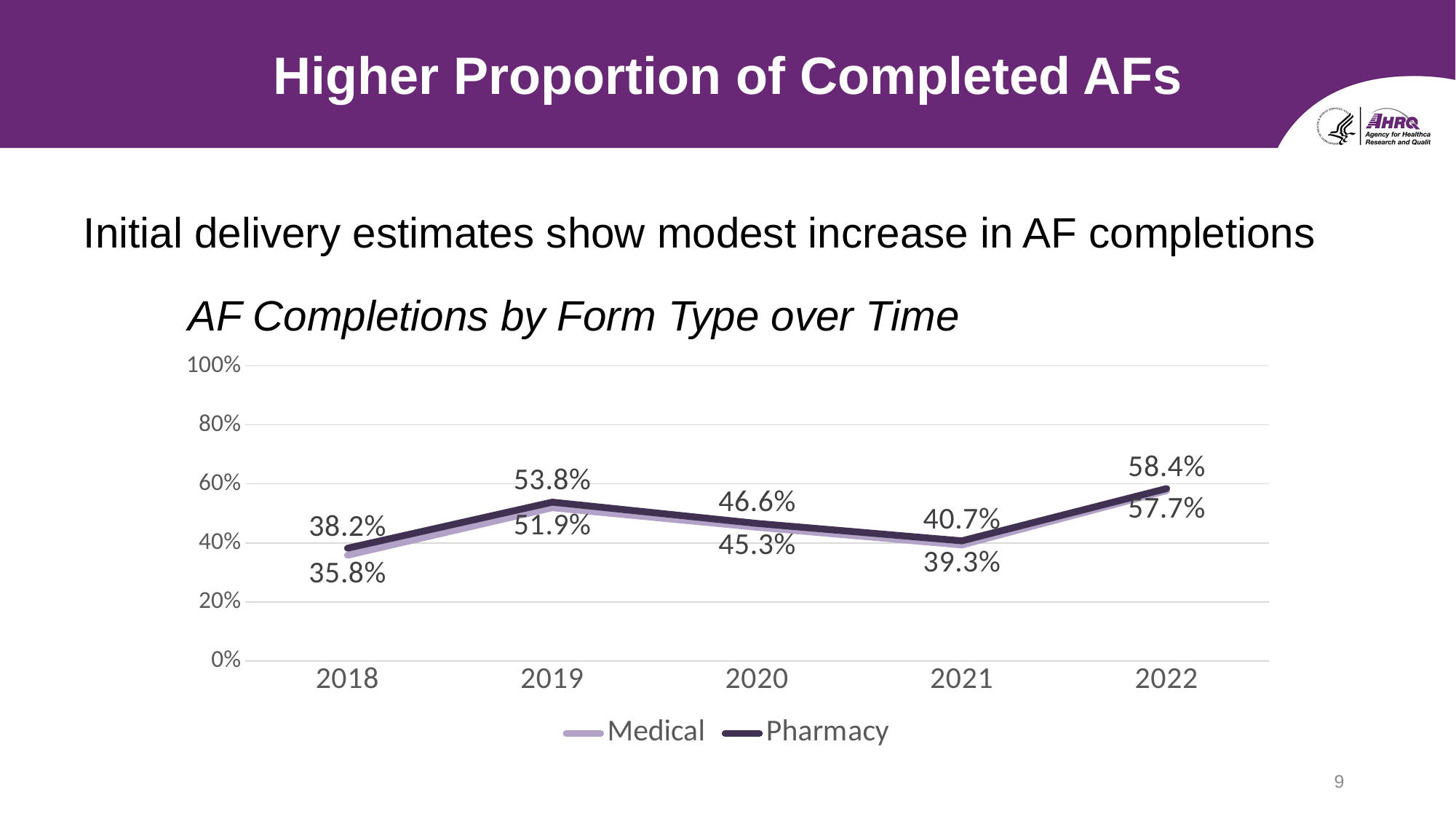
How many series does the legend list? 2 How many years are shown on the x axis? 5 Which is larger in 2020, the Pharmacy value or the Medical value? Pharmacy What kind of chart is shown on the slide? Line chart What is the title of the chart? AF Completions by Form Type over Time What is the difference between the Pharmacy and Medical values in 2019? 1.9% What is the Medical value for 2018? 35.8% What is the Pharmacy value for 2021? 40.7% In which year is the Pharmacy value highest? 2022 What is the Pharmacy value for 2022? 58.4% What is the Medical value for 2020? 45.3% In which year is the Medical value lowest? 2018